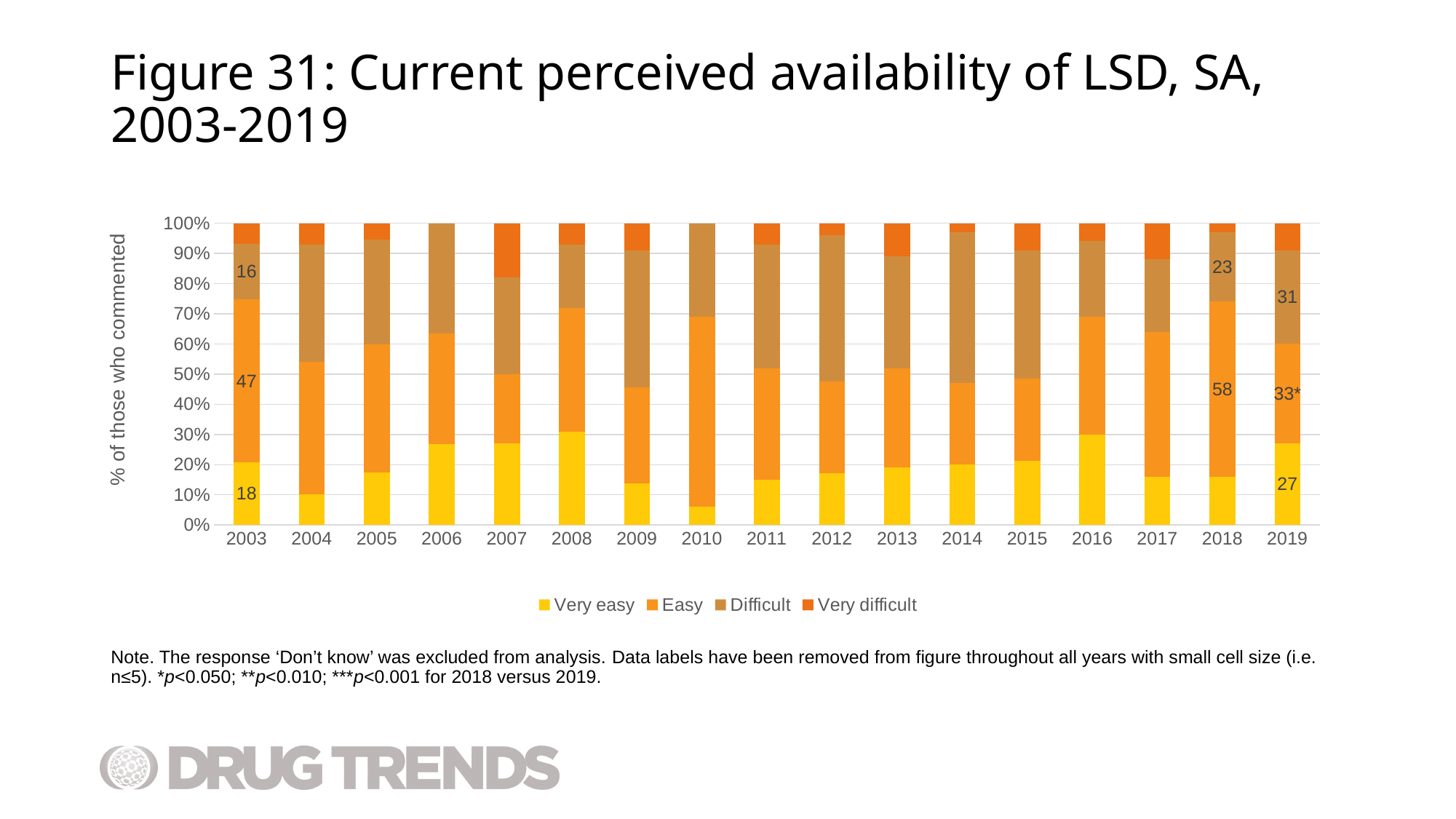
Which year has the larger Easy data label, 2018 or 2019? 2018 What is the title of the y axis? % of those who commented What is the data label for the Difficult segment in 2019? 31 What is the data label for the Difficult segment in 2018? 23 What is the data label for the Very easy segment in 2019? 27 How many years are shown along the x axis of the chart? 17 What kind of chart is shown on the slide? Stacked bar chart What is the difference between the Easy data labels for 2018 and 2019? 25 What is the data label for the Easy segment in 2018? 58 Is the Very easy value for 2010 greater or less than 10%? less How many series does the legend list? 4 What is the data label for the Easy segment in 2003? 47